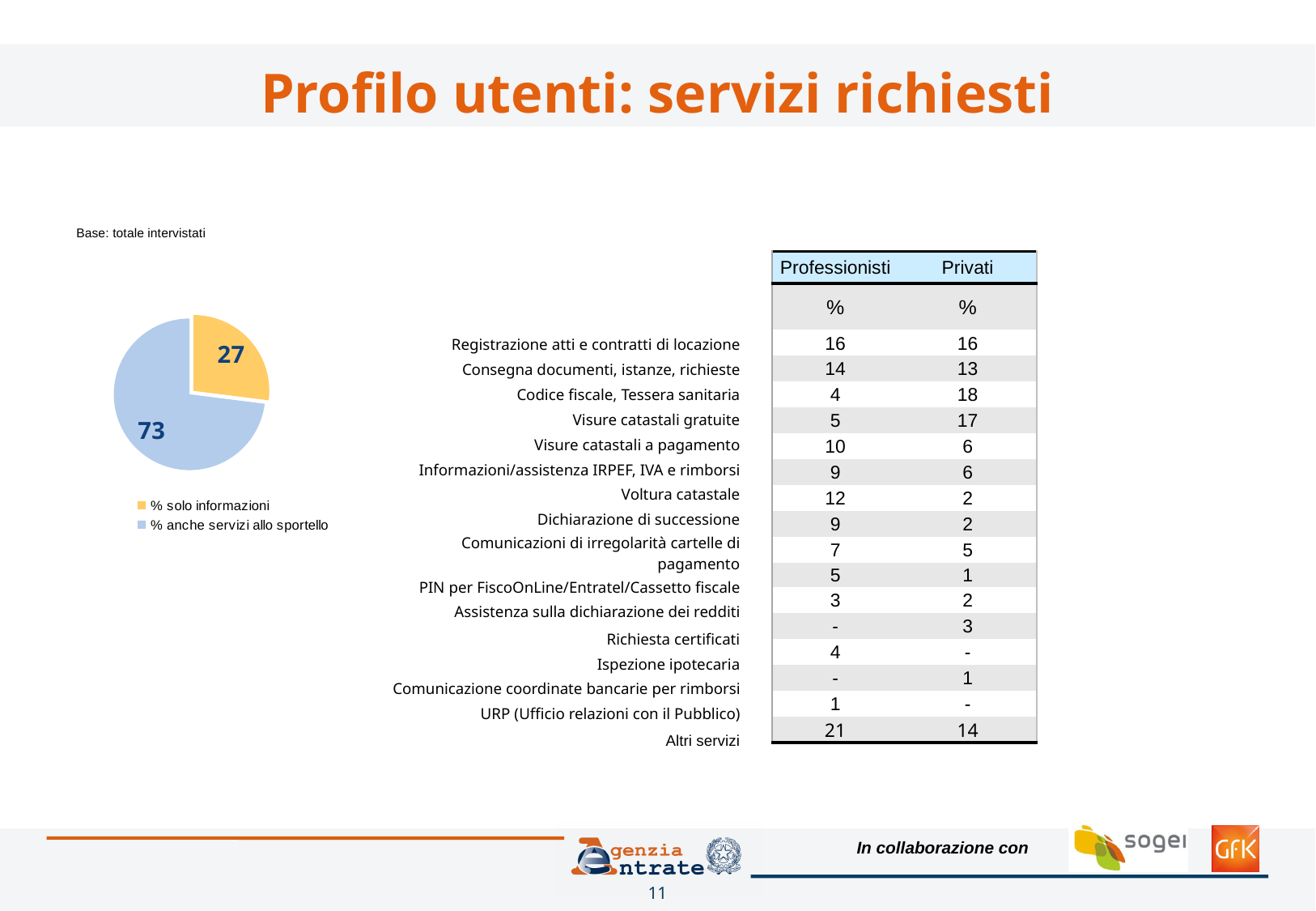
In the pie chart, which category has the largest slice? % anche servizi allo sportello In the pie chart, what is the value for '% solo informazioni'? 27 What type of chart is shown on the left of the slide? pie chart How many entries does the pie chart's legend list? 2 In the pie chart, which category has the smallest slice? % solo informazioni In the pie chart, which is larger: '% solo informazioni' or '% anche servizi allo sportello'? % anche servizi allo sportello In the pie chart, what colour is the slice for '% solo informazioni'? yellow How many slices does the pie chart have? 2 In the pie chart, what is the value for '% anche servizi allo sportello'? 73 What base is stated for the pie chart on the slide? Base: totale intervistati In the pie chart, what is the difference between the value for '% anche servizi allo sportello' and the value for '% solo informazioni'? 46